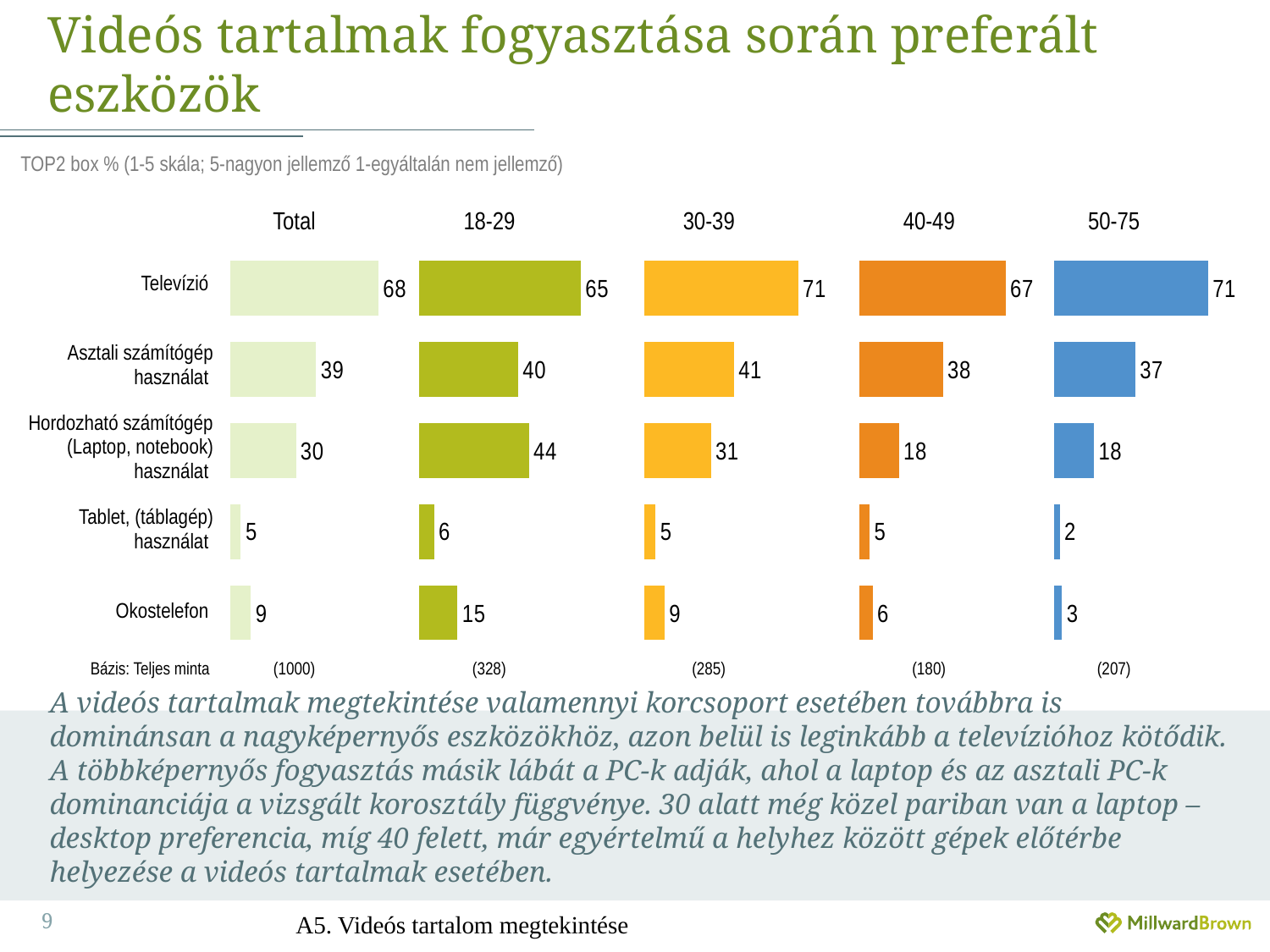
How many categories are shown in the Total chart? 5 In the 18-29 chart, which is larger: the value for Asztali számítógép használat or the value for Hordozható számítógép (Laptop, notebook) használat? Hordozható számítógép (Laptop, notebook) használat In the 50-75 chart, what is the value for Okostelefon? 3 In the 18-29 chart, what is the value for Hordozható számítógép (Laptop, notebook) használat? 44 In the 40-49 chart, which category has the highest value? Televízió How many age-group charts (excluding Total) are shown on the slide? 4 In the 50-75 chart, which category has the lowest value? Tablet, (táblagép) használat What is the base (Bázis) sample size shown under the 18-29 chart? (328) In the 40-49 chart, what is the difference between the values for Asztali számítógép használat and Hordozható számítógép (Laptop, notebook) használat? 20 What kind of chart is the 30-39 chart? bar chart In the 30-39 chart, what is the difference between the values for Televízió and Asztali számítógép használat? 30 In the Total chart, what is the value for Televízió? 68